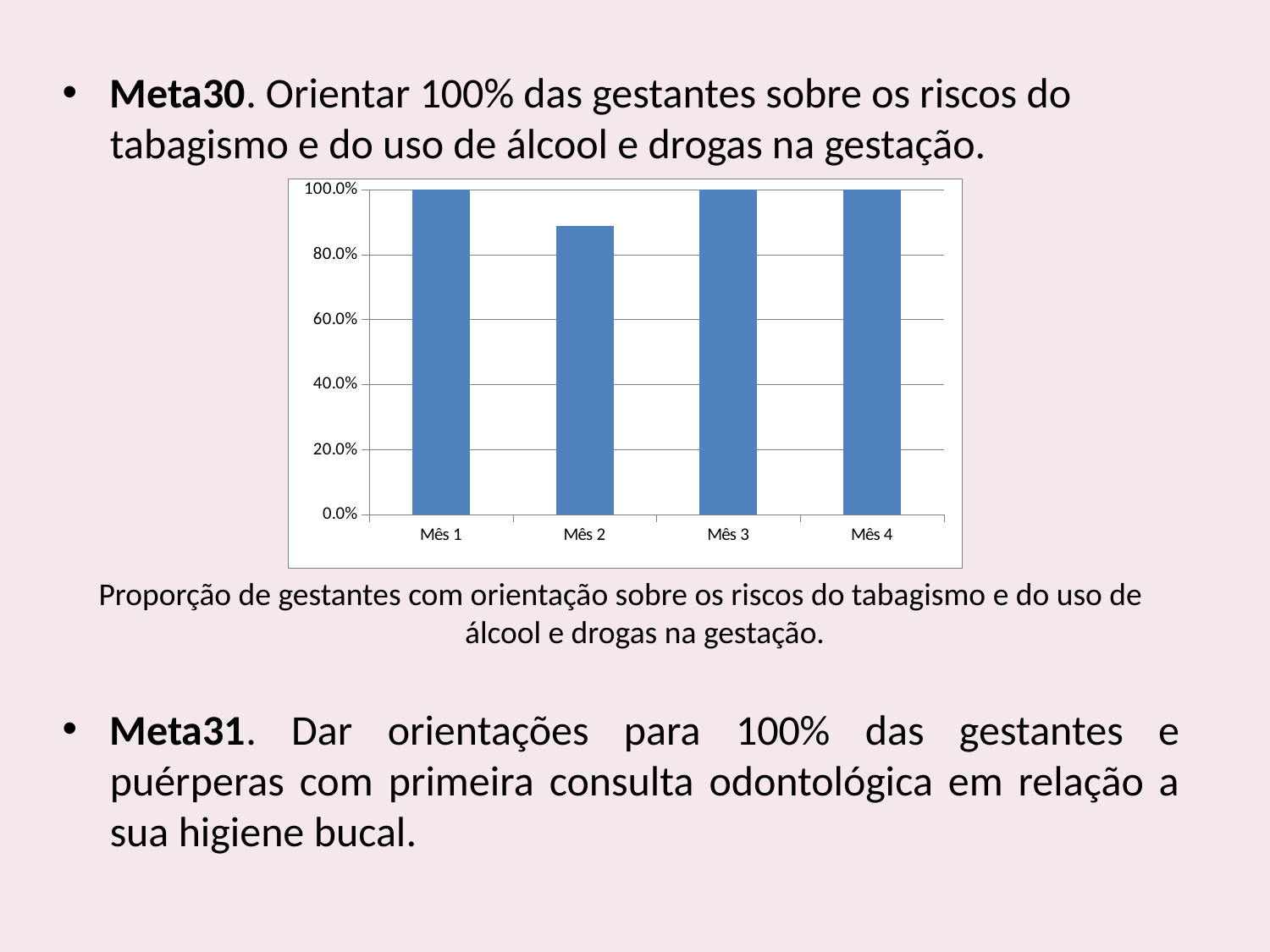
Is the value for Mês 2 greater or less than 80.0%? greater Does the value rise or fall from Mês 1 to Mês 2? fall How many months (categories) are shown on the x axis of the chart? 4 Which is larger, the value for Mês 1 or the value for Mês 2? Mês 1 Is the value for Mês 2 greater or less than 100.0%? less What is the value for Mês 3 in the chart? 100.0% What is the value for Mês 4 in the chart? 100.0% What is the highest value shown on the y axis of the chart? 100.0% What is the value for Mês 1 in the chart? 100.0% Which month has the lowest value in the chart? Mês 2 What kind of chart is shown on the slide? bar chart What colour are the bars in the chart? blue